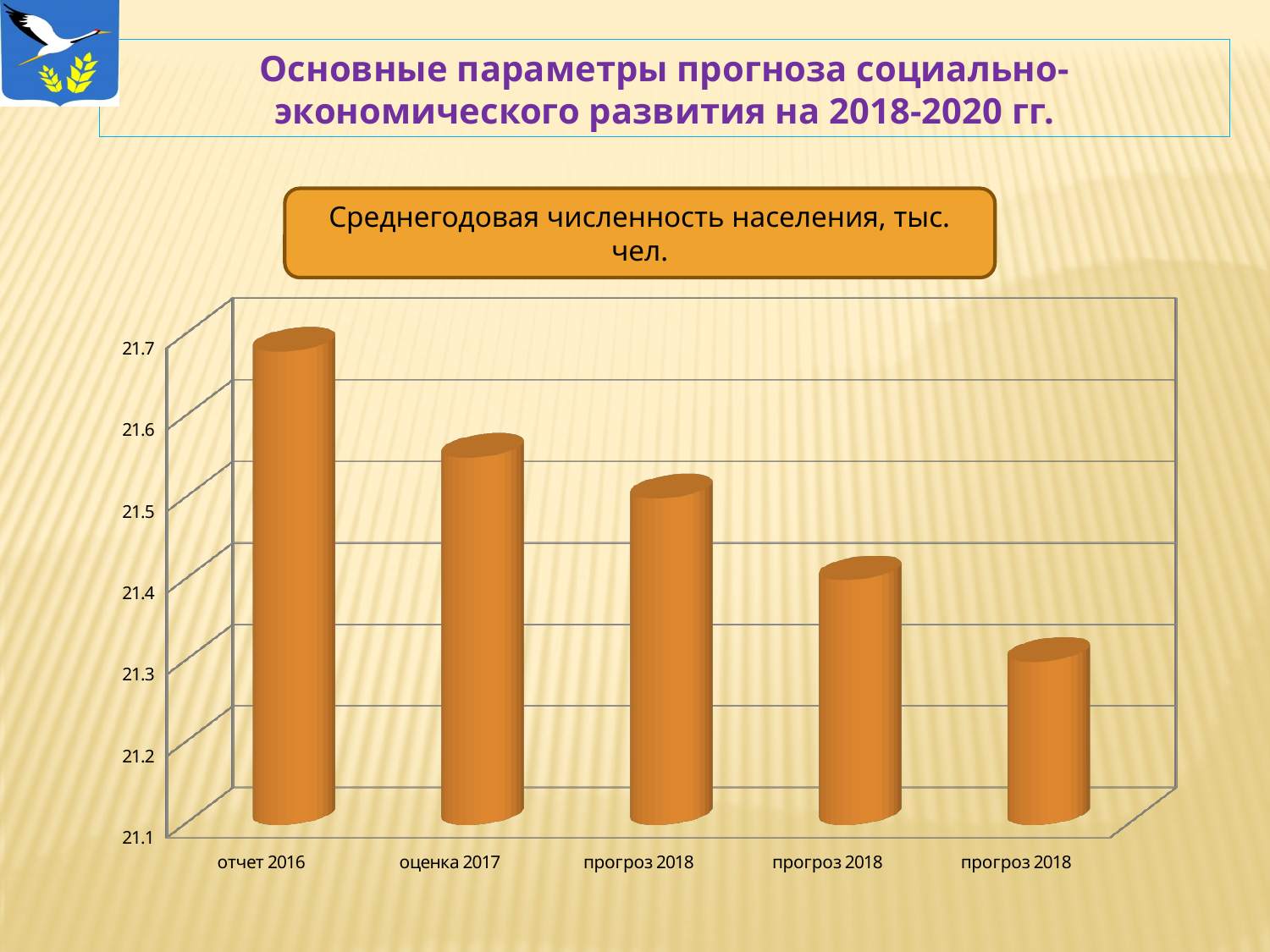
What is the title shown above the chart? Среднегодовая численность населения, тыс. чел. Is the value of the rightmost bar greater or less than 21.4? less Which category has the highest bar? отчет 2016 Is the value for оценка 2017 greater or less than 21.6? less What kind of chart is shown on the slide? bar chart Which bar is the lowest in the chart? the rightmost bar (the last прогроз 2018) Which is larger, the value for отчет 2016 or the value for оценка 2017? отчет 2016 Is the value for оценка 2017 greater or less than 21.5? greater Do the values rise or fall from left to right along the x axis? fall How many bars are plotted in the chart? 5